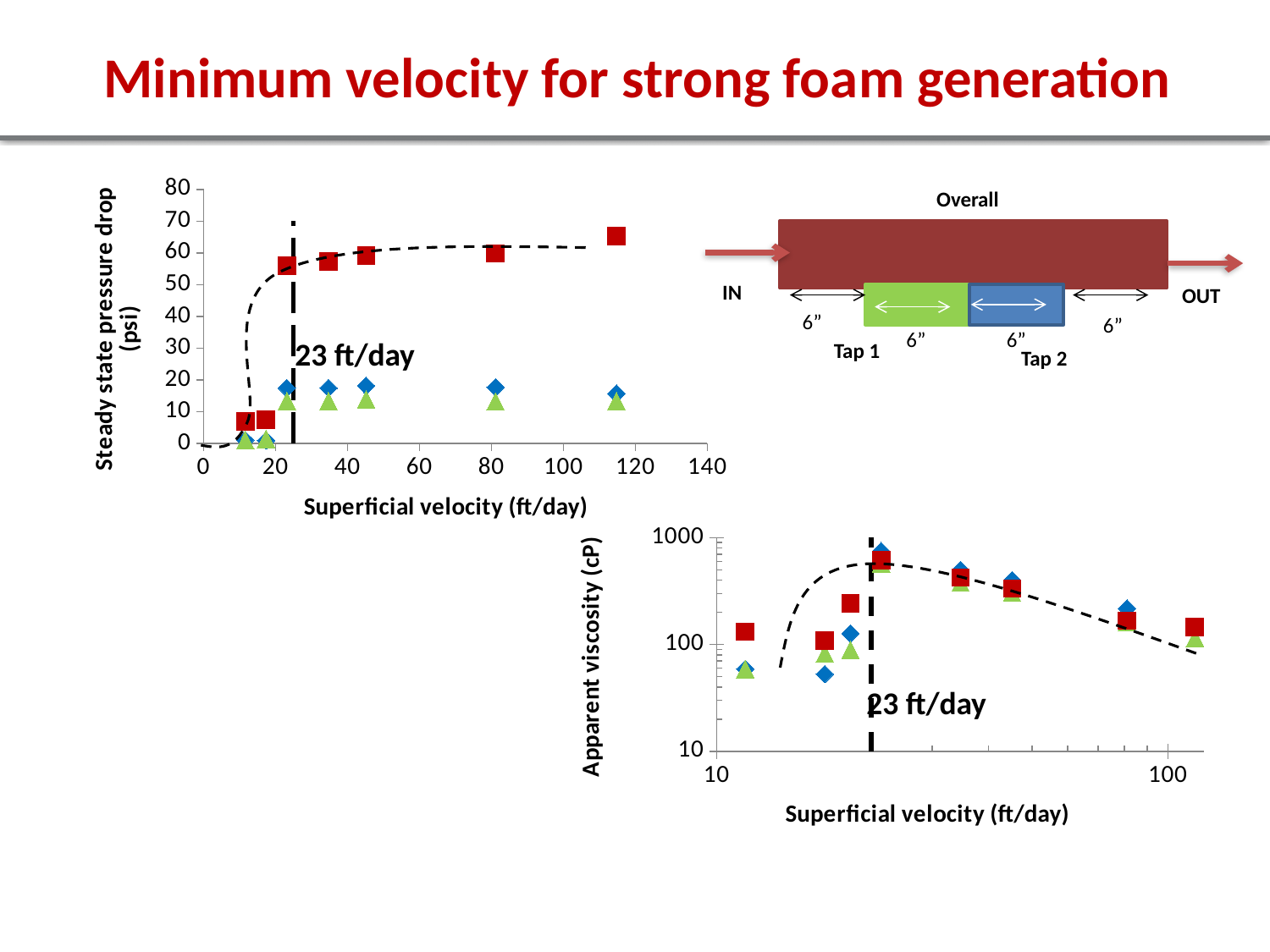
In the top-left chart, is the steady state pressure drop for the red square just above 20 ft/day greater or less than 50? greater In the top-left chart, is the red square value at about 12 ft/day greater or less than 10? less In the top-left chart, how many red square data points are plotted? 7 What kind of chart is the top-left chart showing steady state pressure drop? scatter chart What is the y-axis label of the bottom-right chart? Apparent viscosity (cP) In the bottom-right chart, is the apparent viscosity of the blue diamond at about 11 ft/day greater or less than 100? less In the bottom-right chart, does apparent viscosity rise or fall as superficial velocity increases beyond 23 ft/day? fall In the top-left chart, do the red square values rise or fall as superficial velocity increases from 0 to 140 ft/day? rise In the top-left chart, what velocity is marked by the dashed vertical line annotation? 23 ft/day